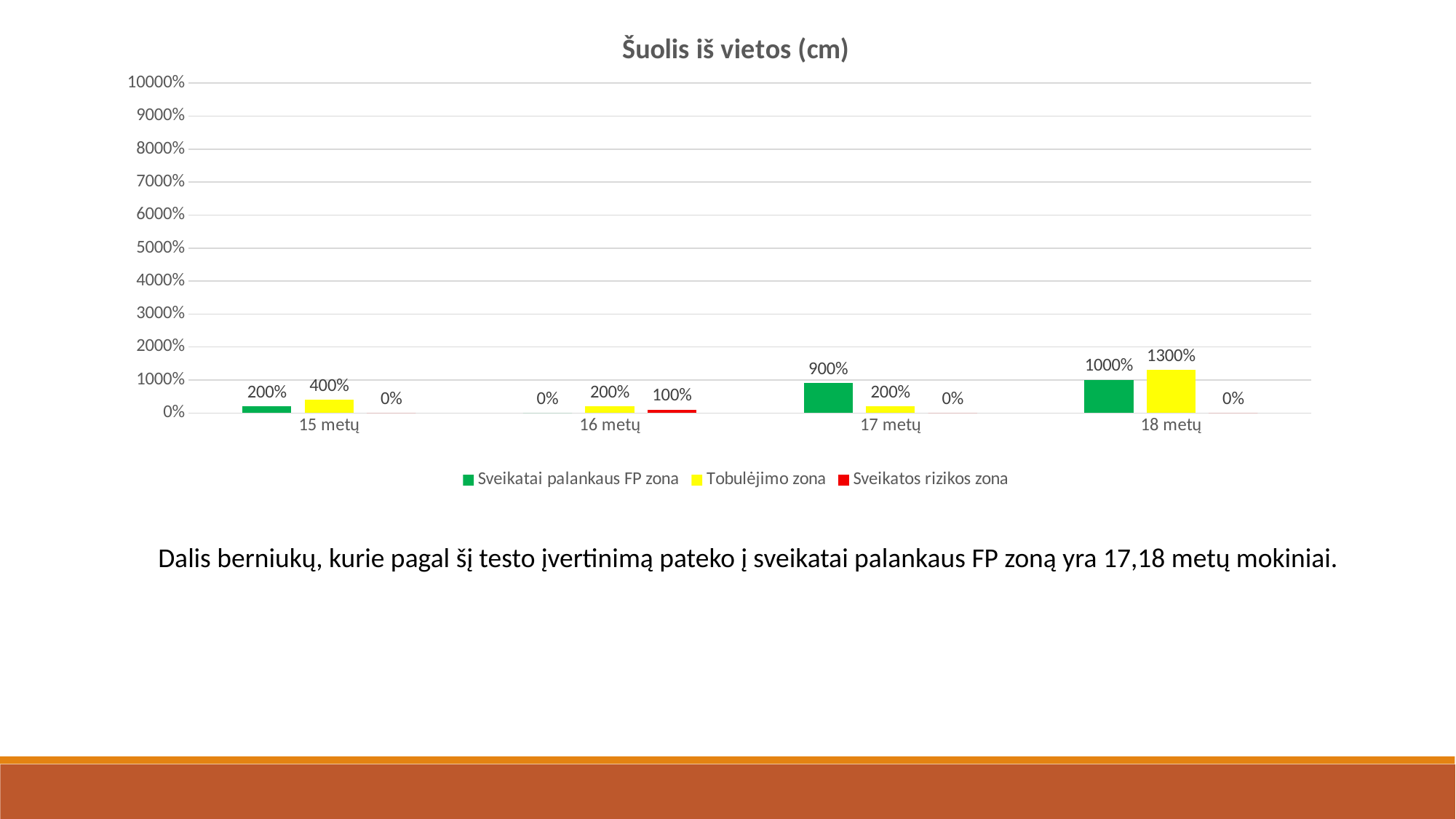
What kind of chart is shown? bar chart What is the value for Sveikatai palankaus FP zona at 16 metų? 0% What is the value for Sveikatai palankaus FP zona at 17 metų? 900% What is the difference between Tobulėjimo zona and Sveikatai palankaus FP zona at 18 metų? 300% Which age group has the lowest value for Sveikatai palankaus FP zona? 16 metų Which is larger at 15 metų: Sveikatai palankaus FP zona or Tobulėjimo zona? Tobulėjimo zona What is the value for Tobulėjimo zona at 18 metų? 1300% How many series does the legend list? 3 Which age group has the highest value for Tobulėjimo zona? 18 metų What is the title of the chart? Šuolis iš vietos (cm) How many age groups are shown on the x axis? 4 What is the value for Sveikatos rizikos zona at 16 metų? 100%